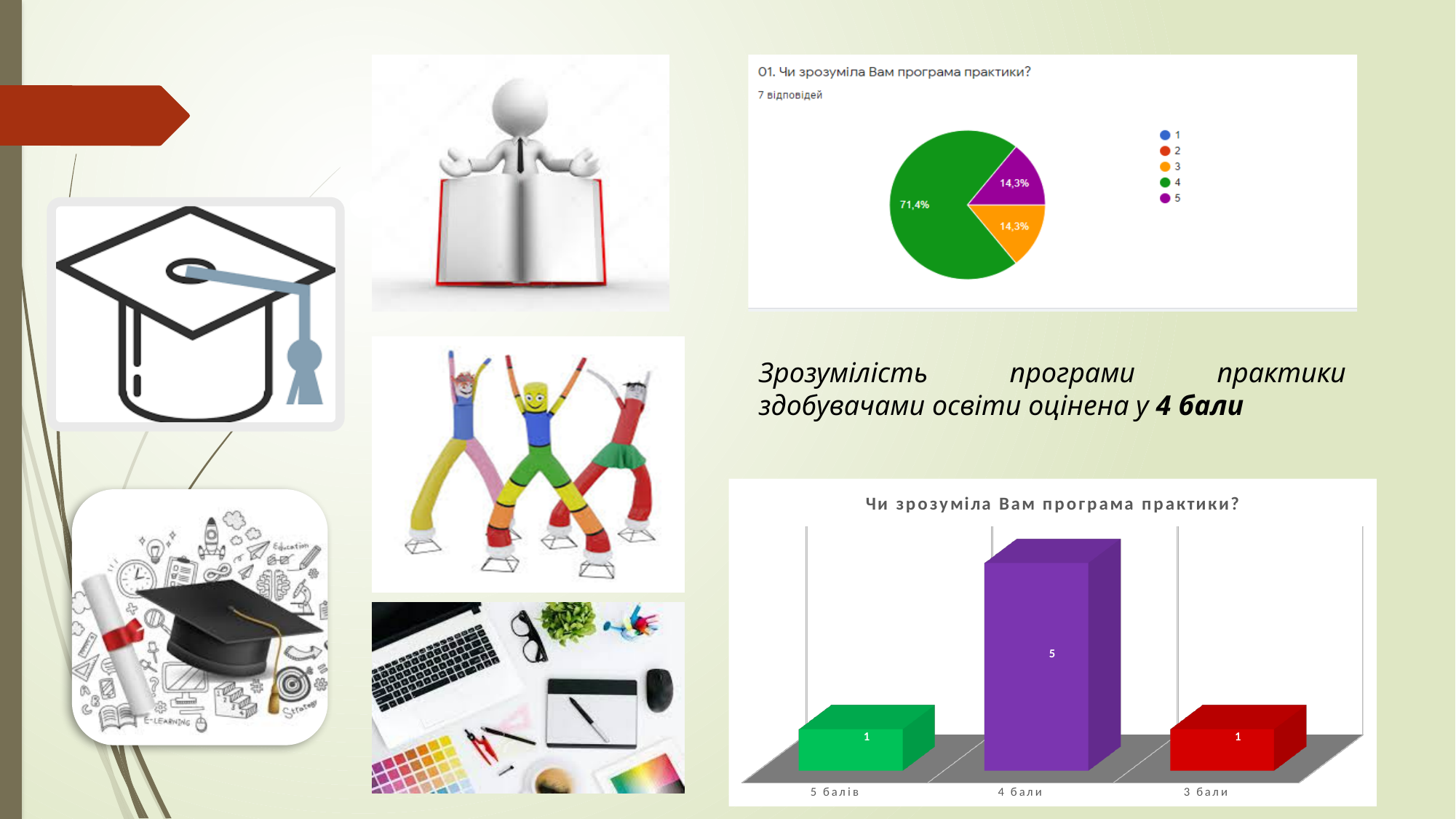
In the pie chart at the top right, what share of responses is shown for the orange slice (rating 3)? 14,3% In the bar chart at the bottom right, what is the difference between the values for '4 бали' and '3 бали'? 4 What kind of chart is the chart at the bottom right of the slide? Bar chart In the bar chart at the bottom right, what is the value for '4 бали'? 5 What kind of chart is the chart at the top right of the slide? Pie chart In the pie chart at the top right, which rating has the largest slice? 4 How many categories are shown in the bar chart at the bottom right? 3 How many entries does the legend of the pie chart at the top right list? 5 How many responses does the pie chart at the top right report (as stated under its title)? 7 відповідей In the bar chart at the bottom right, which category has the highest value? 4 бали In the pie chart at the top right, what share of responses is shown for the green slice (rating 4)? 71,4% In the bar chart at the bottom right, what is the value for '5 балів'? 1